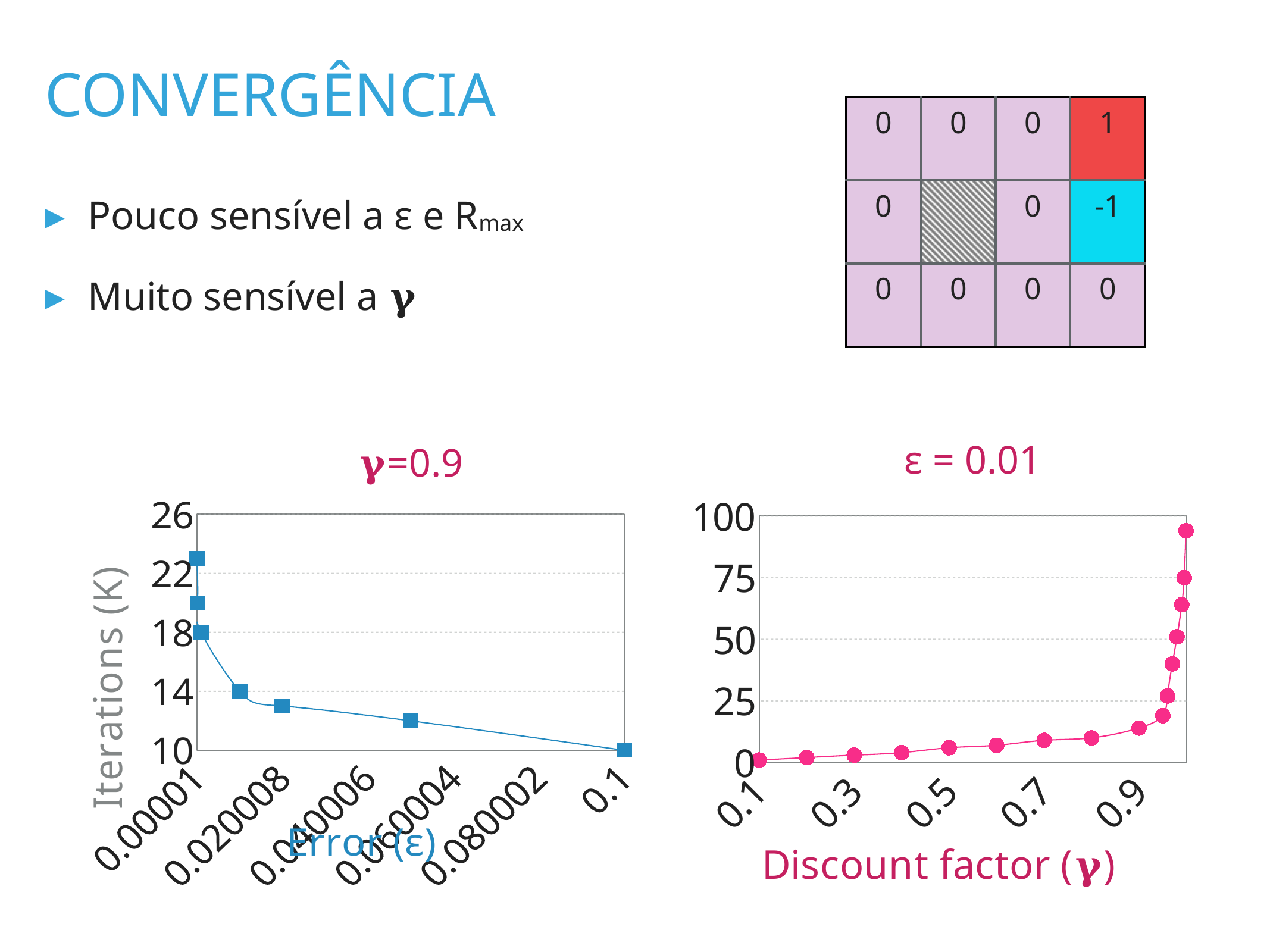
In the right chart (ε = 0.01), which has the larger value: discount factor 0.5 or discount factor 0.9? 0.9 In the left chart (γ=0.9), what is the label of the x axis? Error (ε) In the right chart (ε = 0.01), what is the label of the x axis? Discount factor (γ) How many data points are plotted in the left chart (γ=0.9)? 7 In the left chart (γ=0.9), is the value at error 0.00001 greater or less than 22? greater In the left chart (γ=0.9), do the iterations rise or fall as the error increases along the x axis? fall In the left chart (γ=0.9), is the value at error 0.1 greater or less than 14? less In the right chart (ε = 0.01), is the value at discount factor 0.9 greater or less than 25? less In the right chart (ε = 0.01), do the values rise or fall as the discount factor increases along the x axis? rise What kind of chart is the right chart titled ε = 0.01? line chart What kind of chart is the left chart titled γ=0.9? line chart